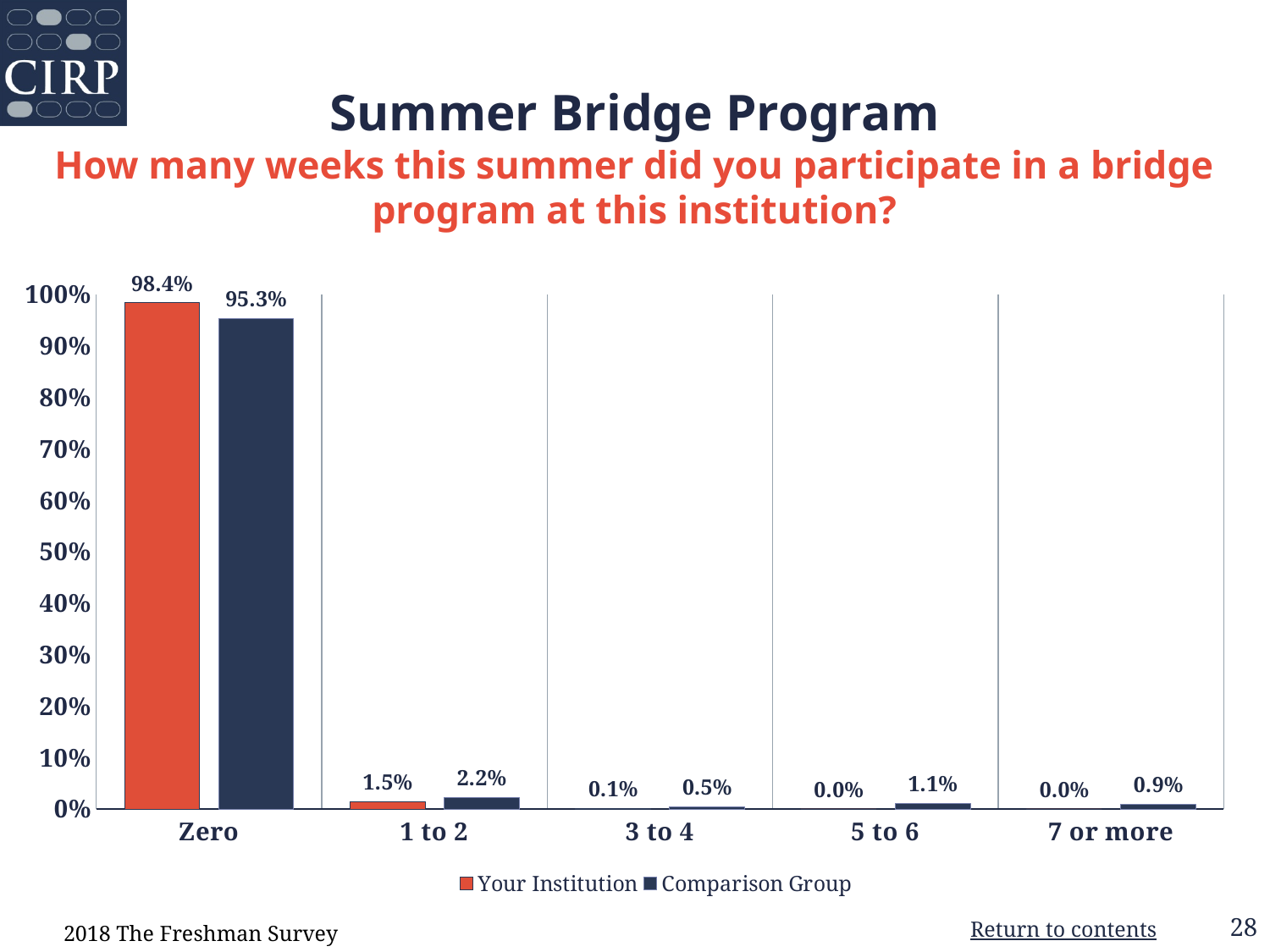
What is the Your Institution value for the 3 to 4 weeks category? 0.1% What percentage of Your Institution respondents reported Zero weeks in a bridge program? 98.4% What is the difference between the Comparison Group and Your Institution for the 5 to 6 category? 1.1% What kind of chart is shown on the slide? Bar chart Which category has the highest value for the Comparison Group? Zero What is the difference between Your Institution and the Comparison Group for the Zero category? 3.1% Is the Comparison Group value for Zero greater or less than 90%? greater What is the Comparison Group value for the 1 to 2 weeks category? 2.2% For the 1 to 2 category, which series has the larger value, Your Institution or Comparison Group? Comparison Group How many series does the legend list? 2 What is the Comparison Group value for the 7 or more weeks category? 0.9% How many categories are shown on the x axis? 5